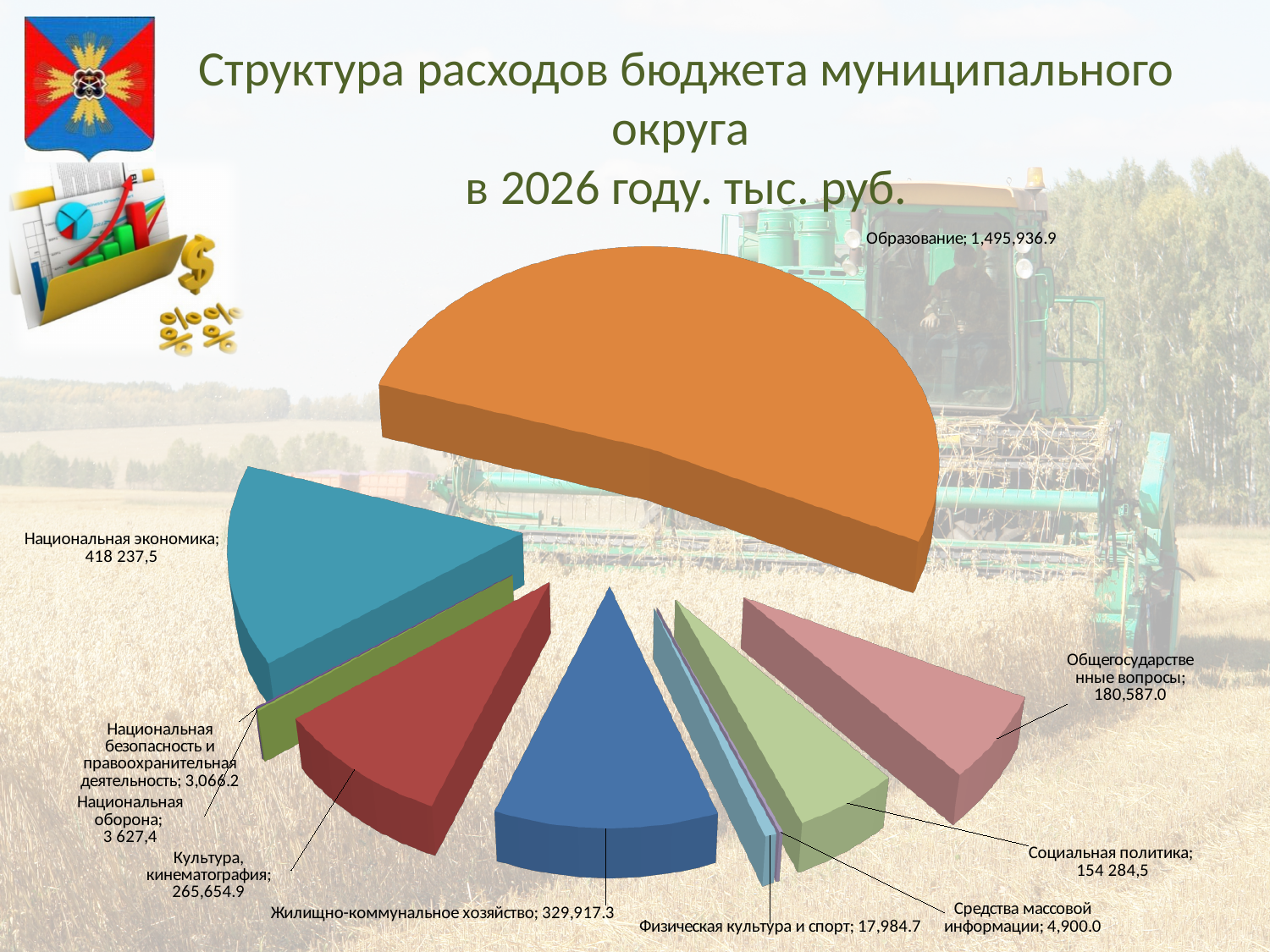
What is the value for Средства массовой информации? 4,900.0 What is the value for Образование? 1,495,936.9 What kind of chart is shown on the slide? Pie chart Which is larger: Общегосударственные вопросы or Социальная политика? Общегосударственные вопросы How many categories does the pie chart show? 10 What is the difference between Жилищно-коммунальное хозяйство and Культура, кинематография? 64,262.4 Which category has the largest value? Образование What year does the chart title refer to? 2026 What is the value for Социальная политика? 154 284,5 What is the value for Жилищно-коммунальное хозяйство? 329,917.3 What is the value for Национальная экономика? 418 237,5 Which category has the smallest value? Национальная безопасность и правоохранительная деятельность